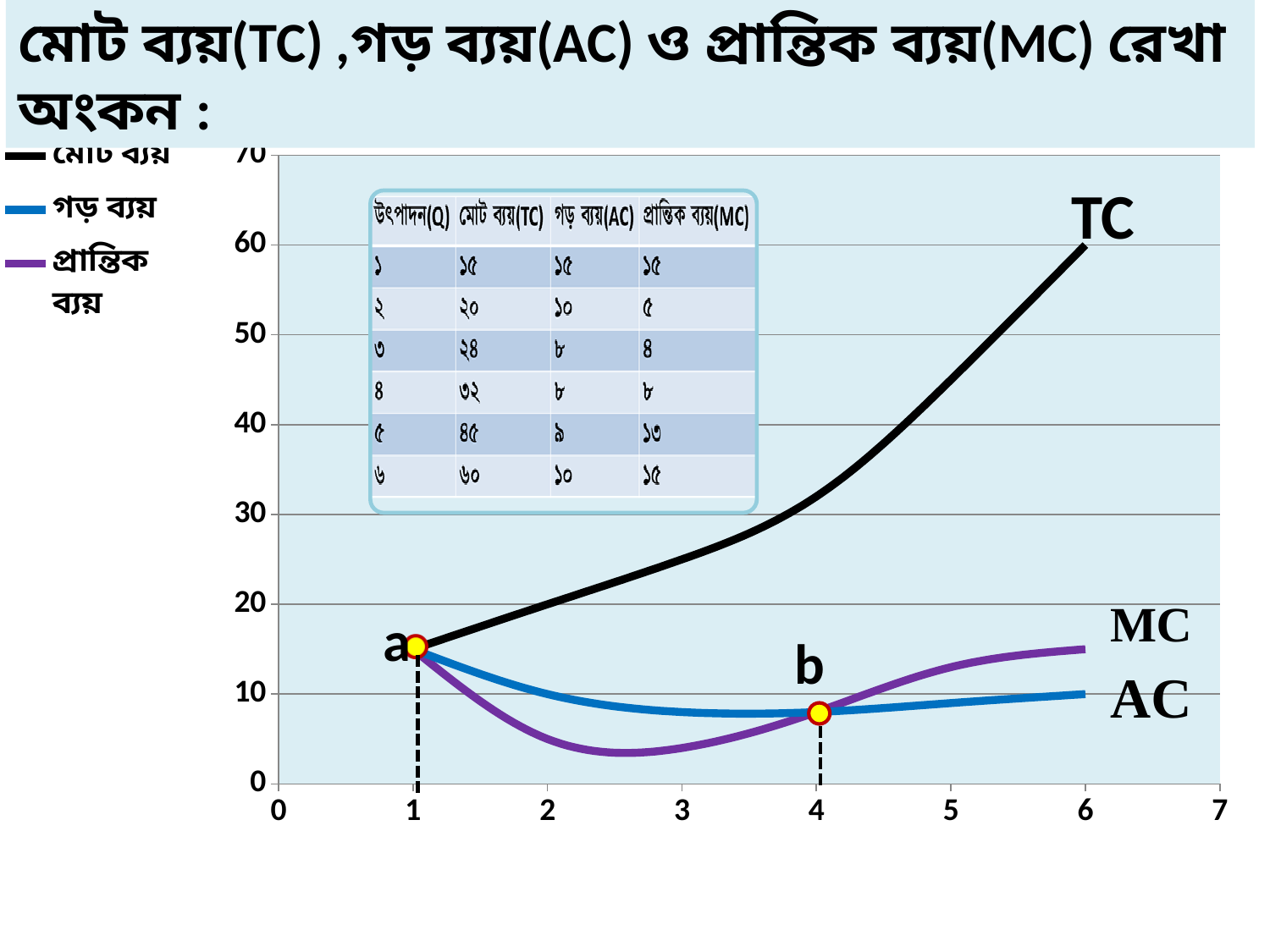
What colour is the TC line? black Is the value of the MC line at output 3 greater or less than 10? less What is the value of the TC line at output 6? 60 Which line is highest at output 6? TC Which line is lowest at output 3? MC How many series does the legend list? 3 Is the value of the TC line at output 5 greater or less than 40? greater What letter labels the point where the AC and MC lines cross at output 4? b Does the TC line rise or fall as output increases from 1 to 6? rises At output 2, which is larger, AC or MC? AC How many output levels (Q) are listed in the table on the chart? 6 What kind of chart is shown on the slide? line chart